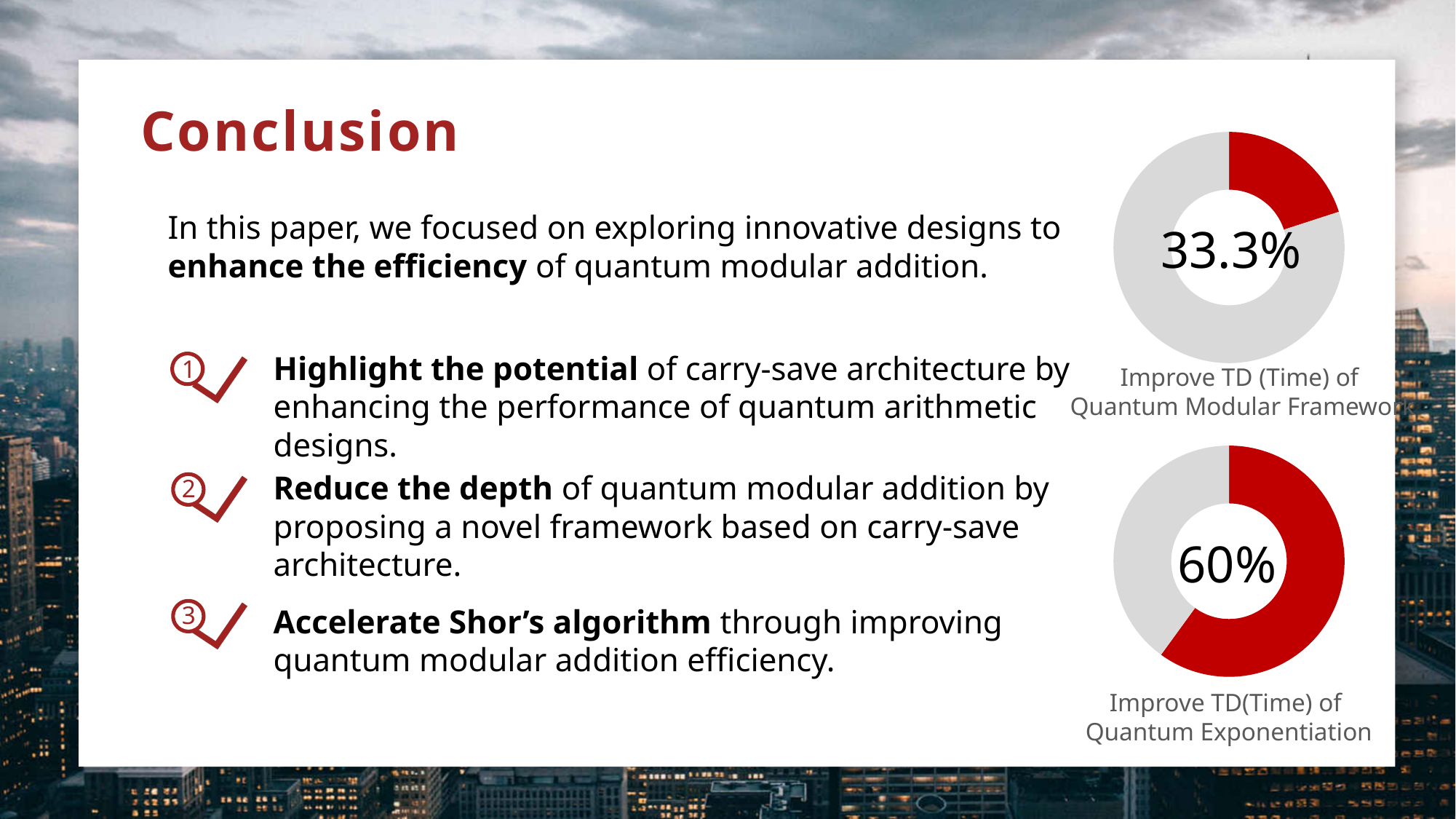
Is the value shown in the Quantum Exponentiation donut chart greater or less than 50%? greater Is the value shown in the Quantum Modular Framework donut chart greater or less than 50%? less How many donut charts are shown on the slide? 2 In the bottom donut chart, what share of the ring is filled in red? 60% What colour is used for the filled (highlighted) portion of both donut charts? Red What is the difference between the percentage in the Quantum Exponentiation chart and the percentage in the Quantum Modular Framework chart? 26.7% What kind of chart is used to show the 33.3% improvement for the Quantum Modular Framework? Donut (pie) chart Which of the two donut charts shows the larger percentage, the Quantum Modular Framework chart or the Quantum Exponentiation chart? Quantum Exponentiation What value is shown in the centre of the bottom donut chart, labelled 'Improve TD(Time) of Quantum Exponentiation'? 60% What is the caption under the bottom donut chart? Improve TD(Time) of Quantum Exponentiation What value is shown in the centre of the top donut chart, labelled 'Improve TD (Time) of Quantum Modular Framework'? 33.3%